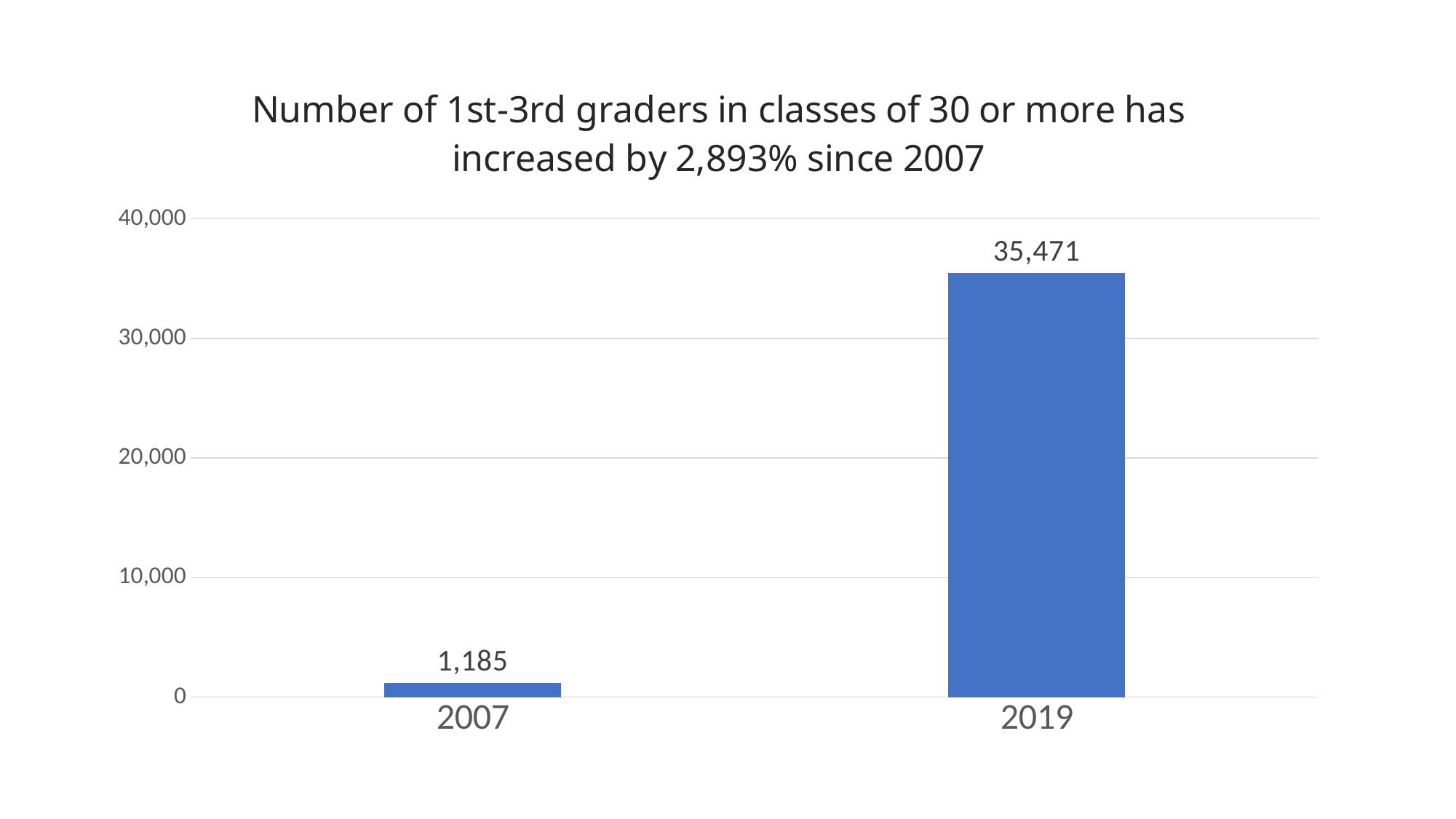
Is the value for 2007 greater or less than 10,000? less What is the value for 2019? 35,471 Do the values rise or fall from 2007 to 2019? rise Is the value for 2019 greater or less than 30,000? greater How many categories are shown on the x axis? 2 Which year has the highest value? 2019 Which year has the lowest value? 2007 By what percentage does the chart title say the number has increased since 2007? 2,893% What is the difference between the values for 2019 and 2007? 34,286 What is the value for 2007? 1,185 Which is larger, the value for 2007 or the value for 2019? 2019 What kind of chart is shown on the slide? bar chart